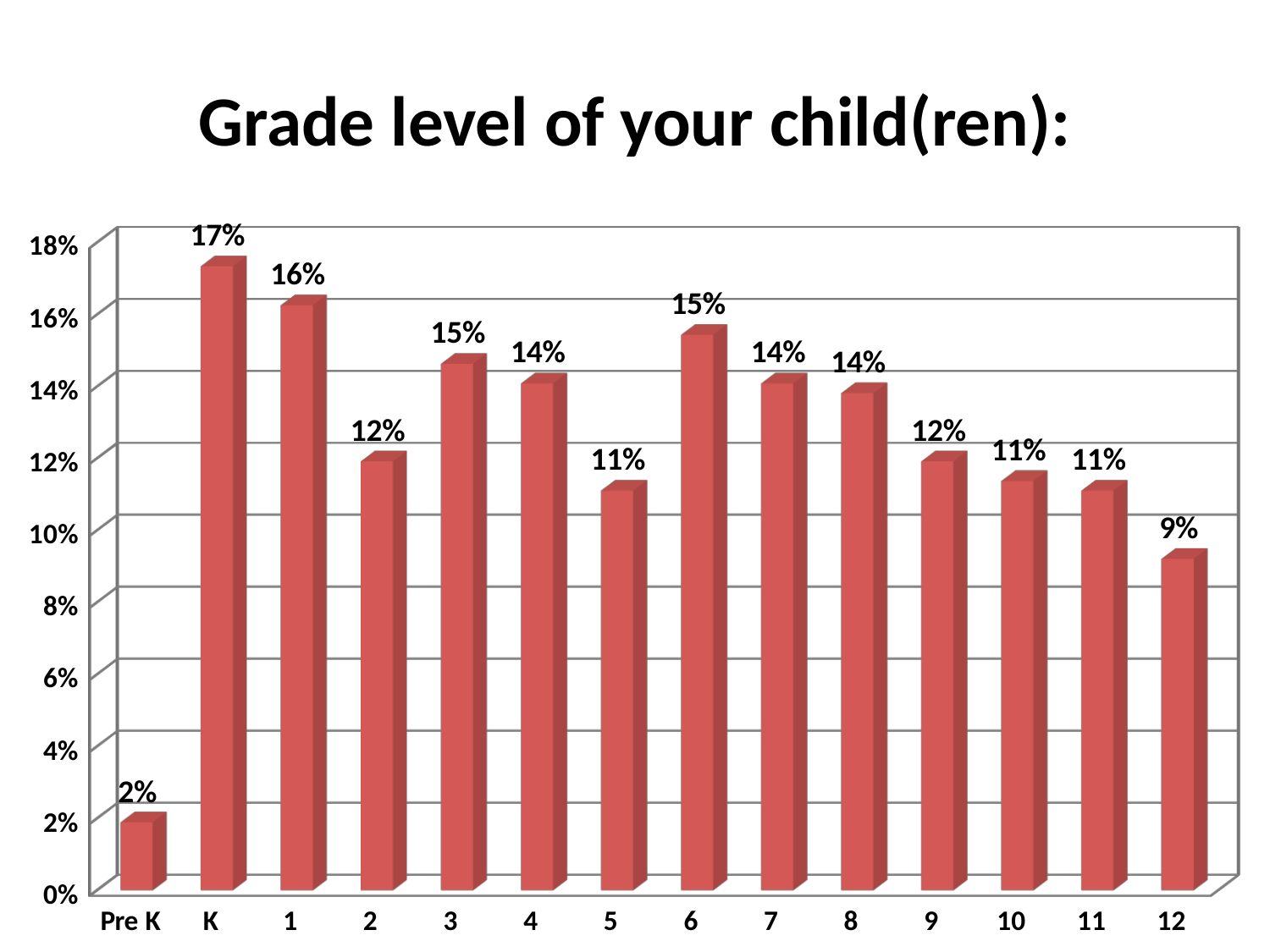
Which is larger, the value for grade 3 or the value for grade 5? grade 3 What is the value for grade 6? 15% What is the value for Pre K? 2% How many grade level categories are shown on the x axis? 14 Which grade level has the highest value? K What is the value for grade 12? 9% What is the value for grade K? 17% Which grade level has the lowest value? Pre K What is the difference between the values for grade 1 and grade 2? 4% What kind of chart is shown on the slide? bar chart What is the difference between the values for grade K and grade 12? 8% What is the title of the chart? Grade level of your child(ren):